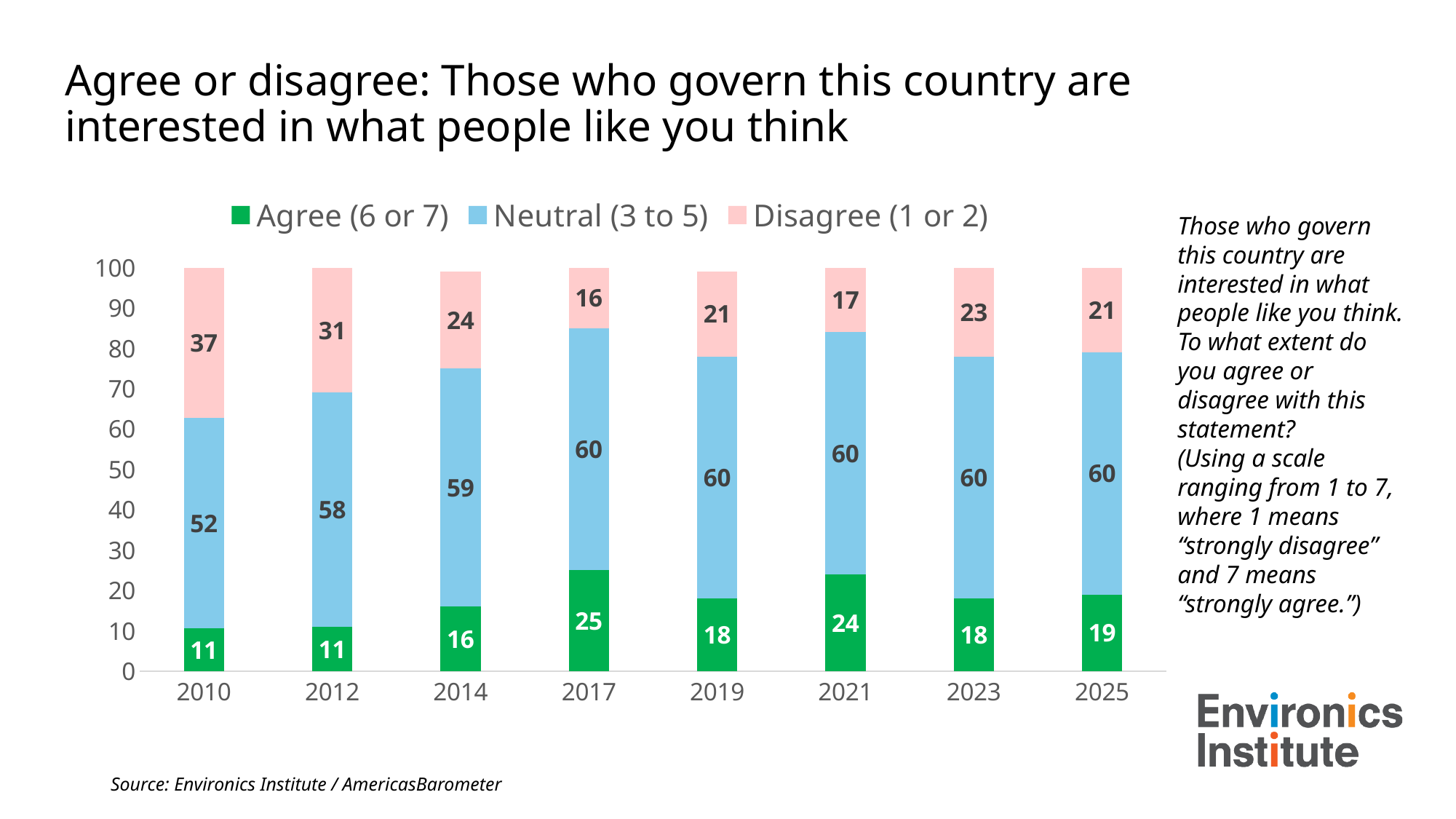
In which year is the Disagree (1 or 2) value lowest? 2017 What kind of chart is shown on the slide? Stacked bar chart What is the Agree (6 or 7) value for 2017? 25 What is the total of the stacked bar for 2012? 100 What is the Neutral (3 to 5) value for 2014? 59 What colour represents the Neutral (3 to 5) series? Light blue How many years are shown on the x axis? 8 What is the difference between the Disagree (1 or 2) values for 2010 and 2025? 16 How many series does the legend list? 3 Which is larger, the Agree (6 or 7) value for 2021 or for 2023? 2021 What is the Disagree (1 or 2) value for 2010? 37 In which year is the Disagree (1 or 2) value highest? 2010